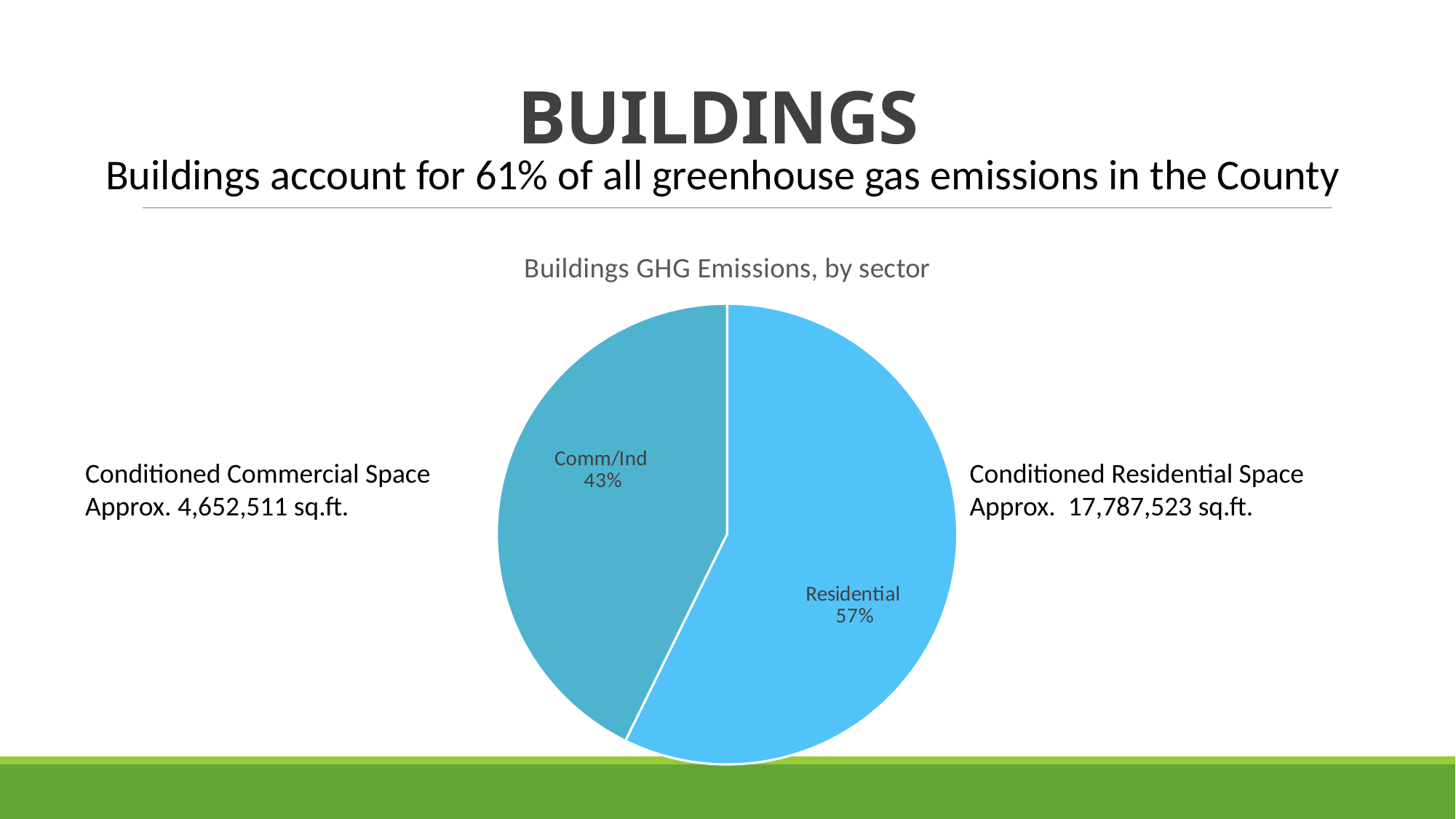
What share of Buildings GHG Emissions does the Residential sector account for? 57% Is the Residential share of Buildings GHG Emissions greater or less than 50%? greater Which sector has the smallest share of Buildings GHG Emissions? Comm/Ind What kind of chart is shown on the slide? Pie chart Is the Comm/Ind share of Buildings GHG Emissions greater or less than 50%? less What share of Buildings GHG Emissions does the Comm/Ind sector account for? 43% How many sectors are shown in the pie chart? 2 By how many percentage points does the Residential share exceed the Comm/Ind share? 14 What is the title of the chart? Buildings GHG Emissions, by sector Which sector has the larger share, Residential or Comm/Ind? Residential Which sector has the largest share of Buildings GHG Emissions? Residential